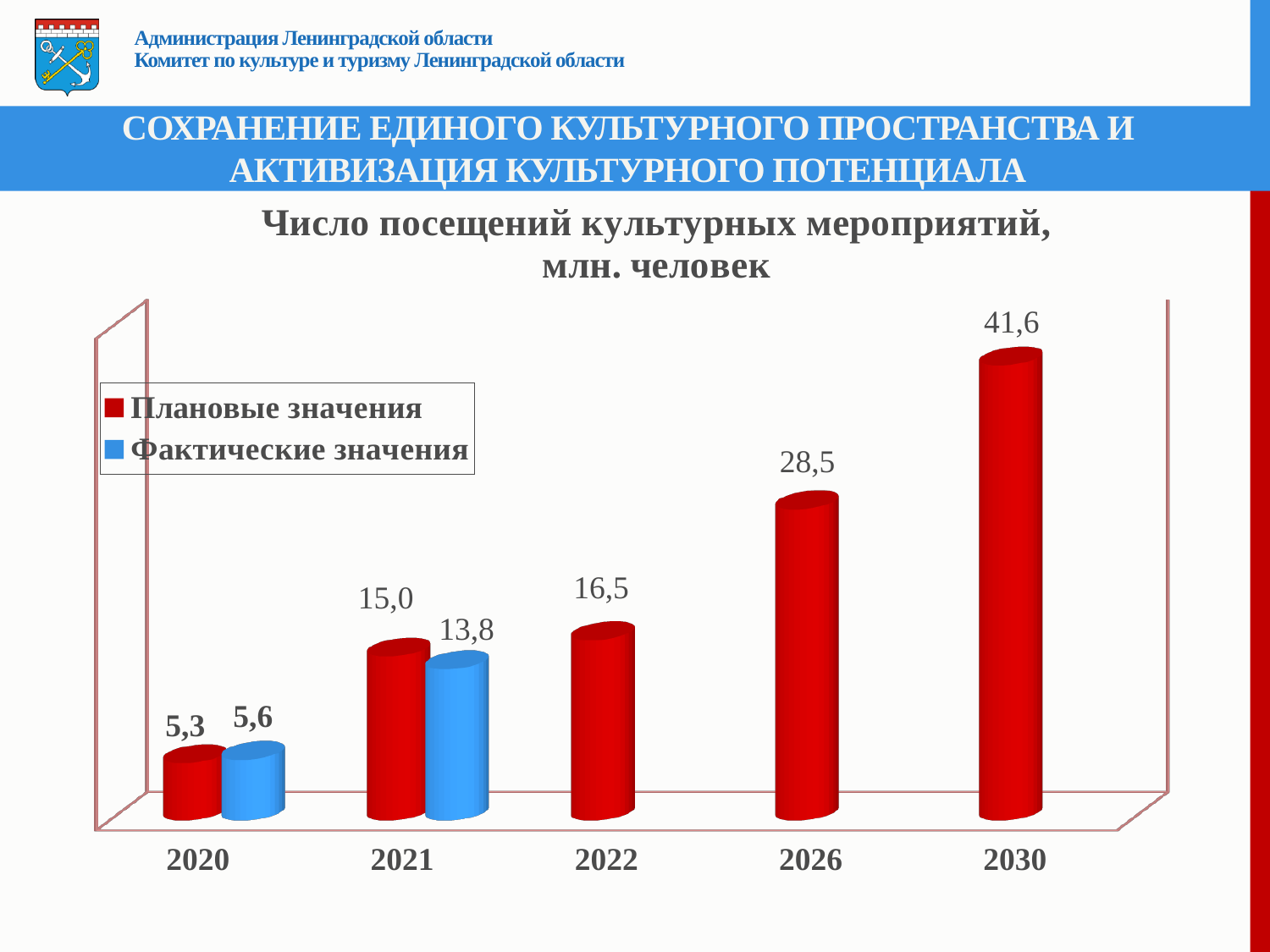
What kind of chart is shown on the slide? Bar chart What is the actual value (Фактические значения) for 2021? 13,8 What is the planned value (Плановые значения) for 2030? 41,6 What is the difference between the planned value and the actual value for 2021? 1,2 Do the planned values (Плановые значения) rise or fall from 2020 to 2030? Rise How many years are shown on the x axis? 5 What is the planned value (Плановые значения) for 2026? 28,5 For 2020, which is larger: the planned value or the actual value? Фактические значения (5,6) What is the title of the chart? Число посещений культурных мероприятий, млн. человек Which year has the lowest planned value (Плановые значения)? 2020 How many series does the legend list? 2 Which year has the highest planned value (Плановые значения)? 2030